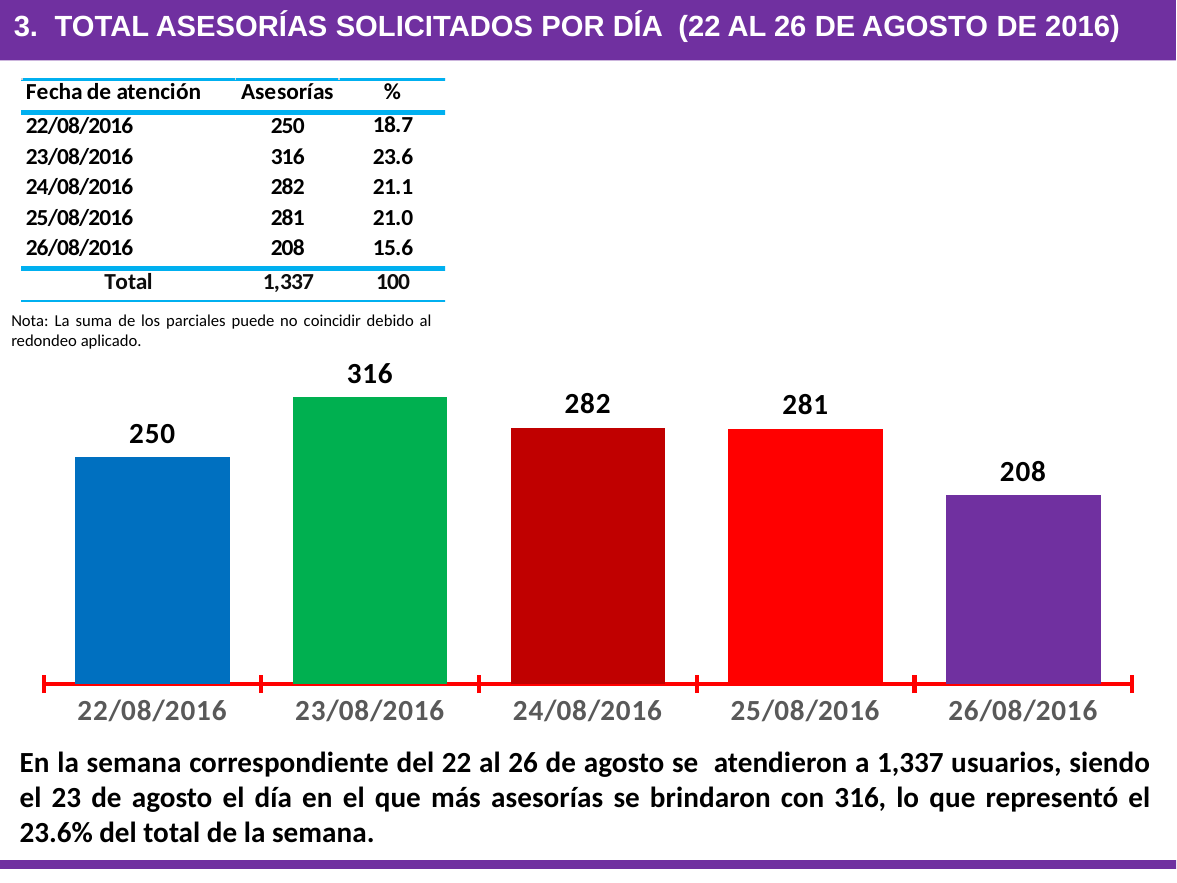
What is the difference between the values for 24/08/2016 and 22/08/2016? 32 Which date has the lowest value? 26/08/2016 What is the total of all the values shown on the chart? 1,337 What is the value for 26/08/2016? 208 What is the value for 23/08/2016? 316 Which is larger, the value for 22/08/2016 or the value for 25/08/2016? 25/08/2016 How many dates are shown on the chart? 5 Which date has the highest value? 23/08/2016 What is the difference between the values for 23/08/2016 and 26/08/2016? 108 What kind of chart is shown on the slide? bar chart What colour is the bar for 23/08/2016? green What is the value for 22/08/2016? 250